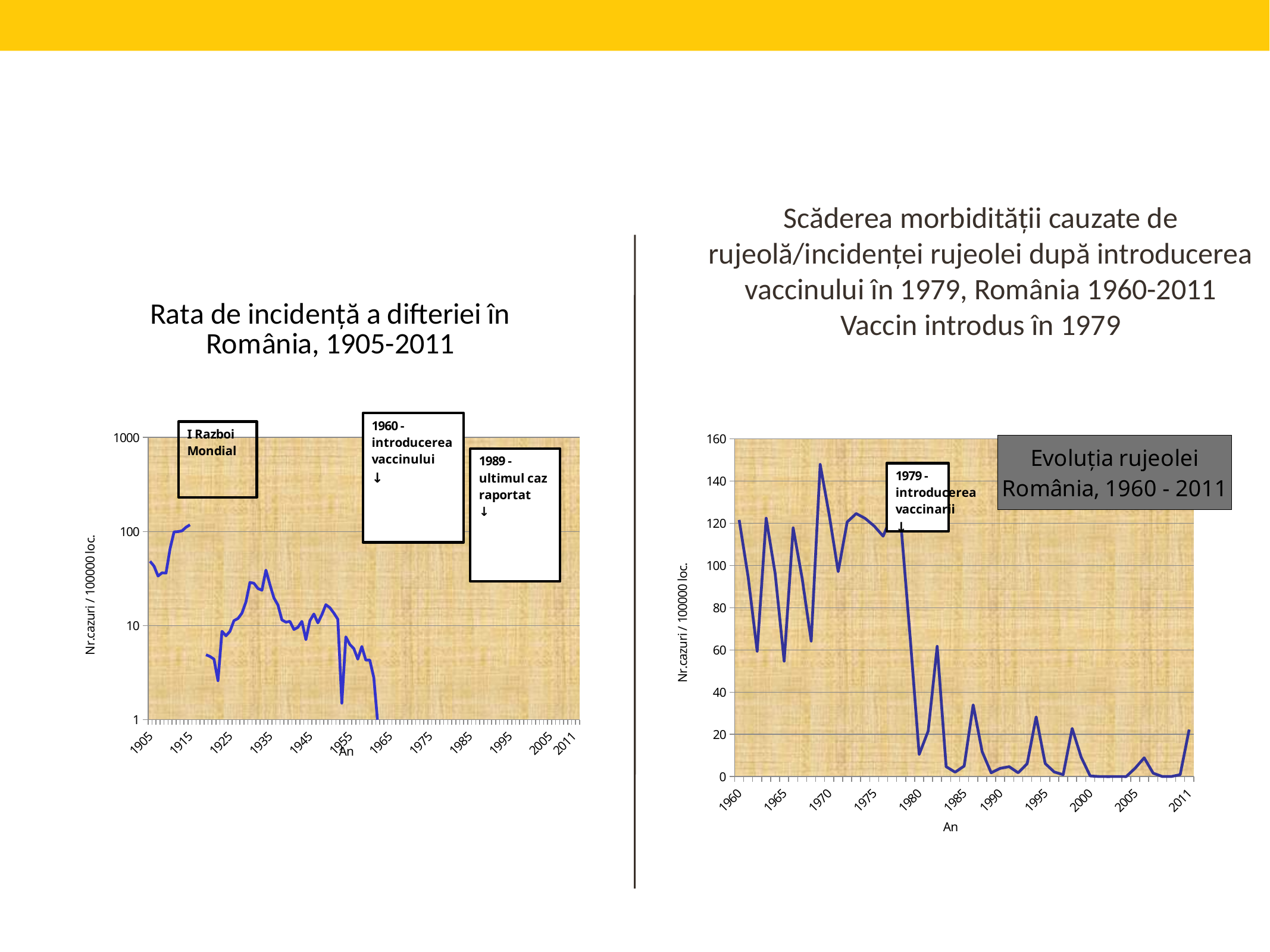
In the left chart 'Rata de incidență a difteriei în România, 1905-2011', is the value around 1935 greater or less than 100? less In the right chart 'Evoluția rujeolei România, 1960 - 2011', is the value for 1980 greater or less than 40? less According to the annotation on the right chart, in which year was measles vaccination introduced? 1979 How many charts are shown on the slide? 2 In the right chart 'Evoluția rujeolei România, 1960 - 2011', is the value for 1990 greater or less than 20? less In the right chart 'Evoluția rujeolei România, 1960 - 2011', do the values overall rise or fall from 1960 to 2011? fall What kind of chart is the right chart, 'Evoluția rujeolei România, 1960 - 2011'? line chart What is the y-axis label of the right chart 'Evoluția rujeolei România, 1960 - 2011'? Nr.cazuri / 100000 loc. What kind of chart is the left chart, 'Rata de incidență a difteriei în România, 1905-2011'? line chart